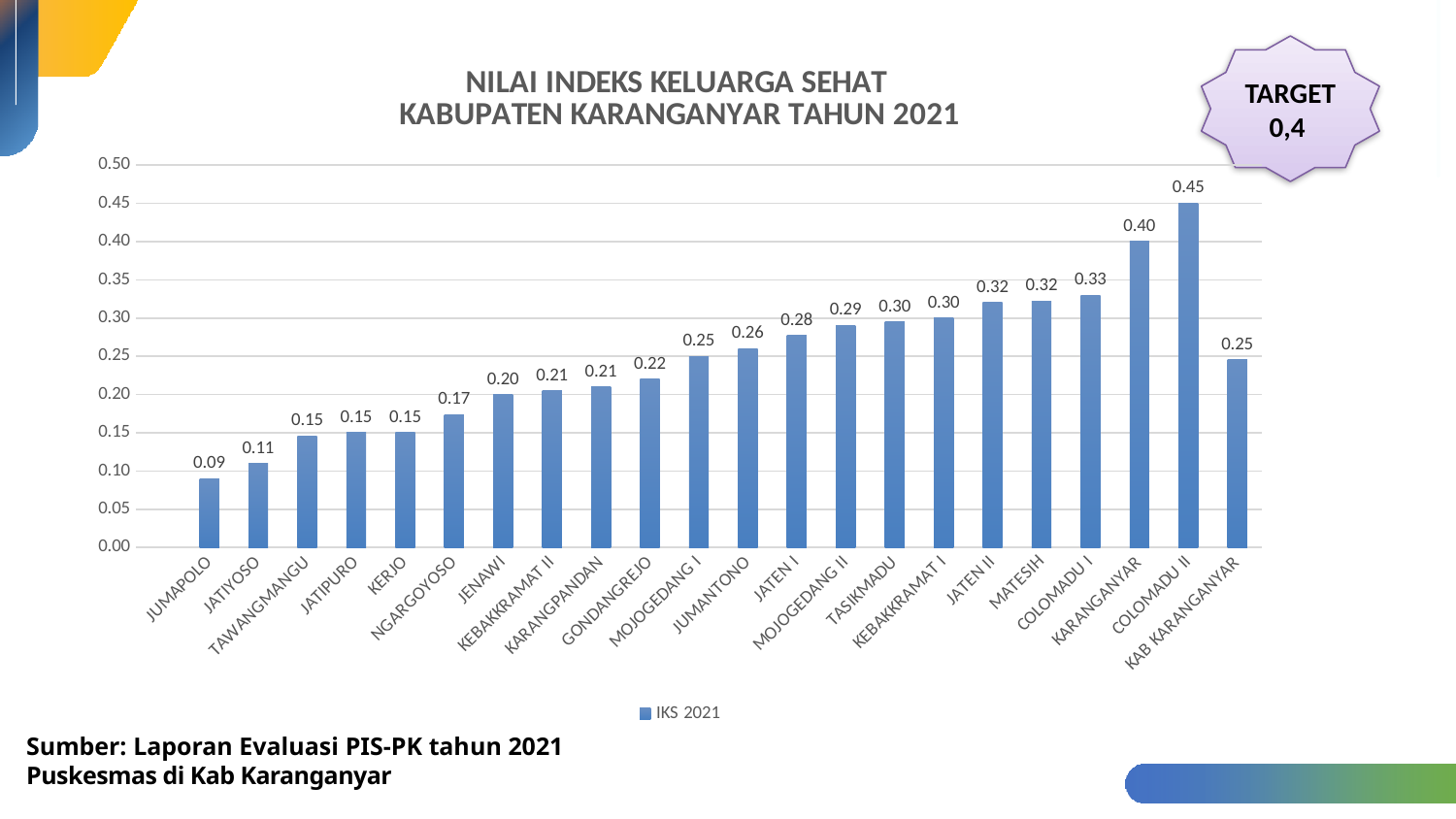
What is the difference between the values for COLOMADU II and KARANGANYAR? 0.05 What is the value for KAB KARANGANYAR? 0.25 What is the value for JUMAPOLO? 0.09 Which is larger, the value for JATEN I or the value for JUMANTONO? JATEN I What is the value for COLOMADU II? 0.45 Is the value for KARANGANYAR greater or less than 0.35? greater What kind of chart is shown on the slide? bar chart How many categories are shown on the x axis? 22 How many series does the legend list? 1 What is the value for GONDANGREJO? 0.22 Which category has the lowest value? JUMAPOLO Which category has the highest value? COLOMADU II